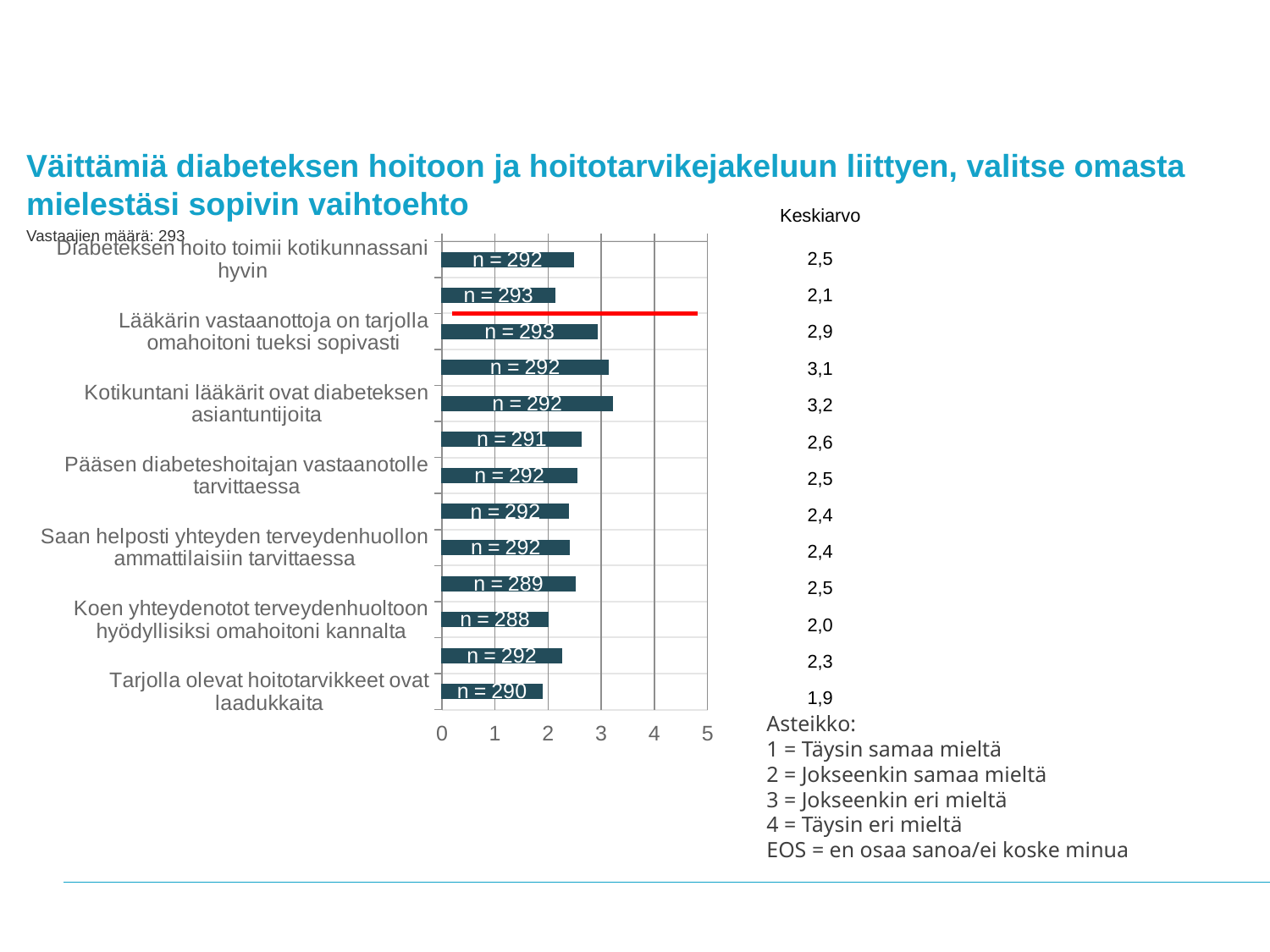
Which bar is longer: the top bar 'Diabeteksen hoito toimii kotikunnassani hyvin' or the bottom bar 'Tarjolla olevat hoitotarvikkeet ovat laadukkaita'? Diabeteksen hoito toimii kotikunnassani hyvin What is the highest value listed in the Keskiarvo column? 3,2 What is the n value printed on the bottom bar, for 'Tarjolla olevat hoitotarvikkeet ovat laadukkaita'? n = 290 What kind of chart is shown on the slide? bar chart How many bars does the chart contain? 13 Is the value of the top bar, 'Diabeteksen hoito toimii kotikunnassani hyvin', greater or less than 3? less What is the Keskiarvo for the top bar, 'Diabeteksen hoito toimii kotikunnassani hyvin'? 2,5 What is the lowest value listed in the Keskiarvo column? 1,9 What is the maximum value shown on the x axis of the chart? 5 What is the difference between the highest and lowest Keskiarvo values? 1,3 What is the n value printed on the top bar, for 'Diabeteksen hoito toimii kotikunnassani hyvin'? n = 292 What is the Keskiarvo for the bottom bar, 'Tarjolla olevat hoitotarvikkeet ovat laadukkaita'? 1,9